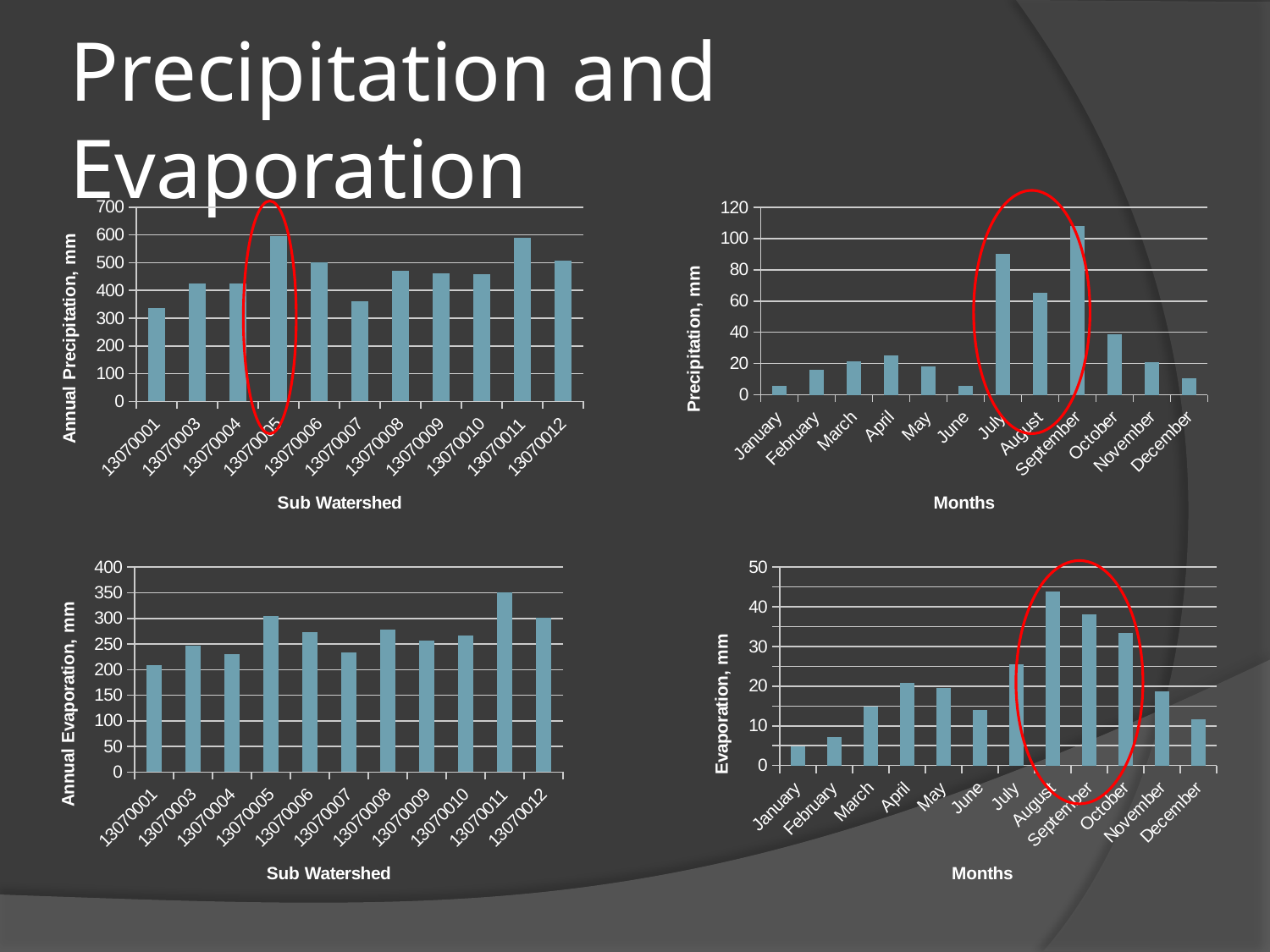
What kind of chart is the bottom-right chart (Evaporation by Months)? bar chart In the bottom-right chart (Evaporation by Months), is the value for January greater or less than 10? less In the top-left chart (Annual Precipitation by Sub Watershed), is the value for 13070007 greater or less than 400? less In the top-left chart (Annual Precipitation by Sub Watershed), which sub watershed has the lowest annual precipitation? 13070001 In the top-right chart (Precipitation by Months), which month has the highest precipitation? September In the bottom-left chart (Annual Evaporation by Sub Watershed), which sub watershed has the highest annual evaporation? 13070011 How many sub watersheds are shown in the top-left chart (Annual Precipitation by Sub Watershed)? 11 In the top-right chart (Precipitation by Months), is the value for December greater or less than 20? less In the bottom-left chart (Annual Evaporation by Sub Watershed), which sub watershed has the lowest annual evaporation? 13070001 In the bottom-right chart (Evaporation by Months), which month has the highest evaporation? August